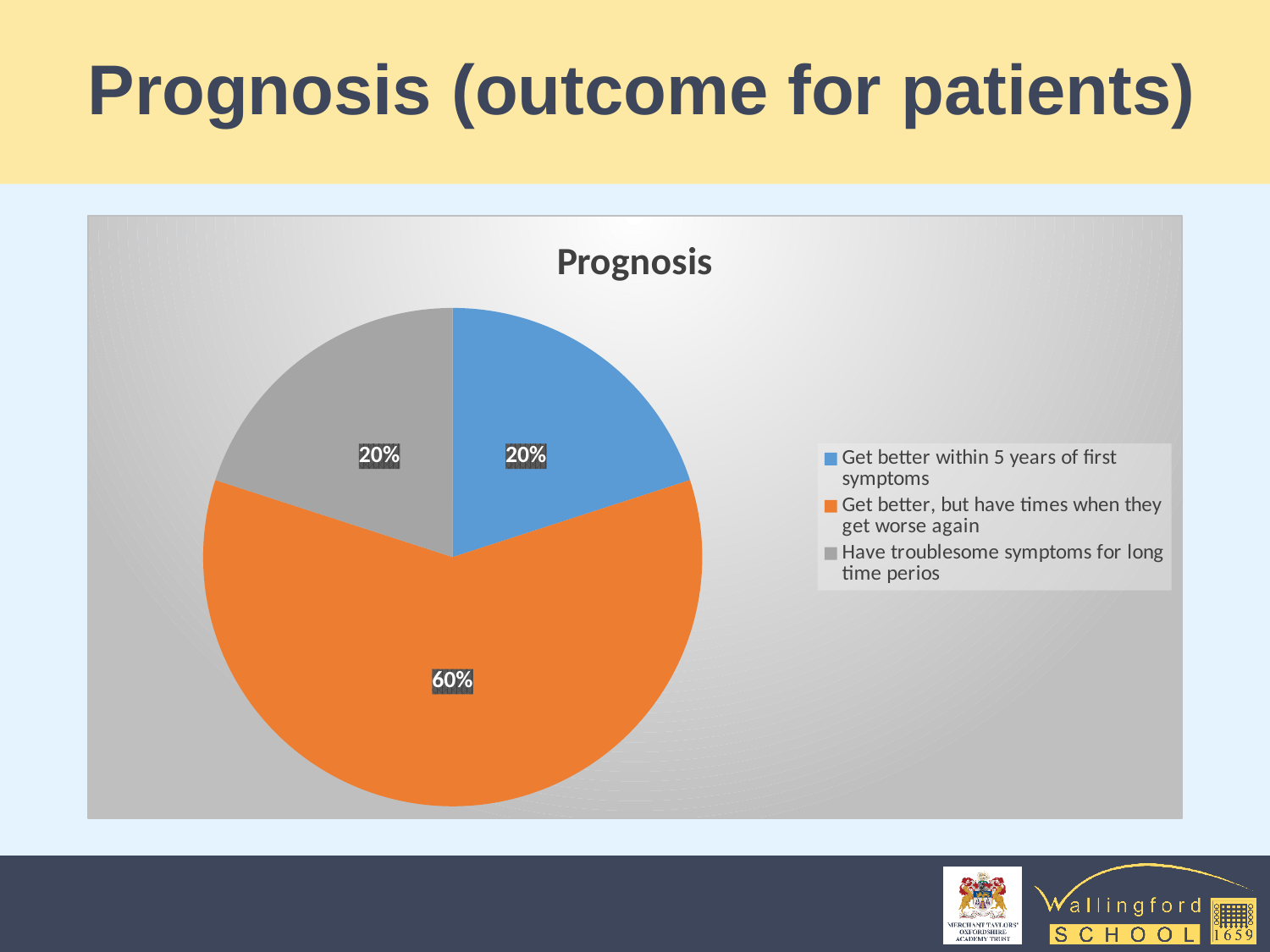
What is the difference in percentage points between 'Get better, but have times when they get worse again' and 'Get better within 5 years of first symptoms'? 40% What colour is the slice for 'Get better within 5 years of first symptoms'? blue Which is larger: the slice for 'Get better, but have times when they get worse again' or the slice for 'Have troublesome symptoms for long time perios'? Get better, but have times when they get worse again What is the title of the chart? Prognosis What kind of chart is shown on the slide? pie chart How many slices does the pie chart have? 3 Which category has the largest slice of the pie? Get better, but have times when they get worse again What share of the pie is 'Have troublesome symptoms for long time perios'? 20% What share of the pie is 'Get better within 5 years of first symptoms'? 20% What share of the pie is 'Get better, but have times when they get worse again'? 60% How many entries does the legend list? 3